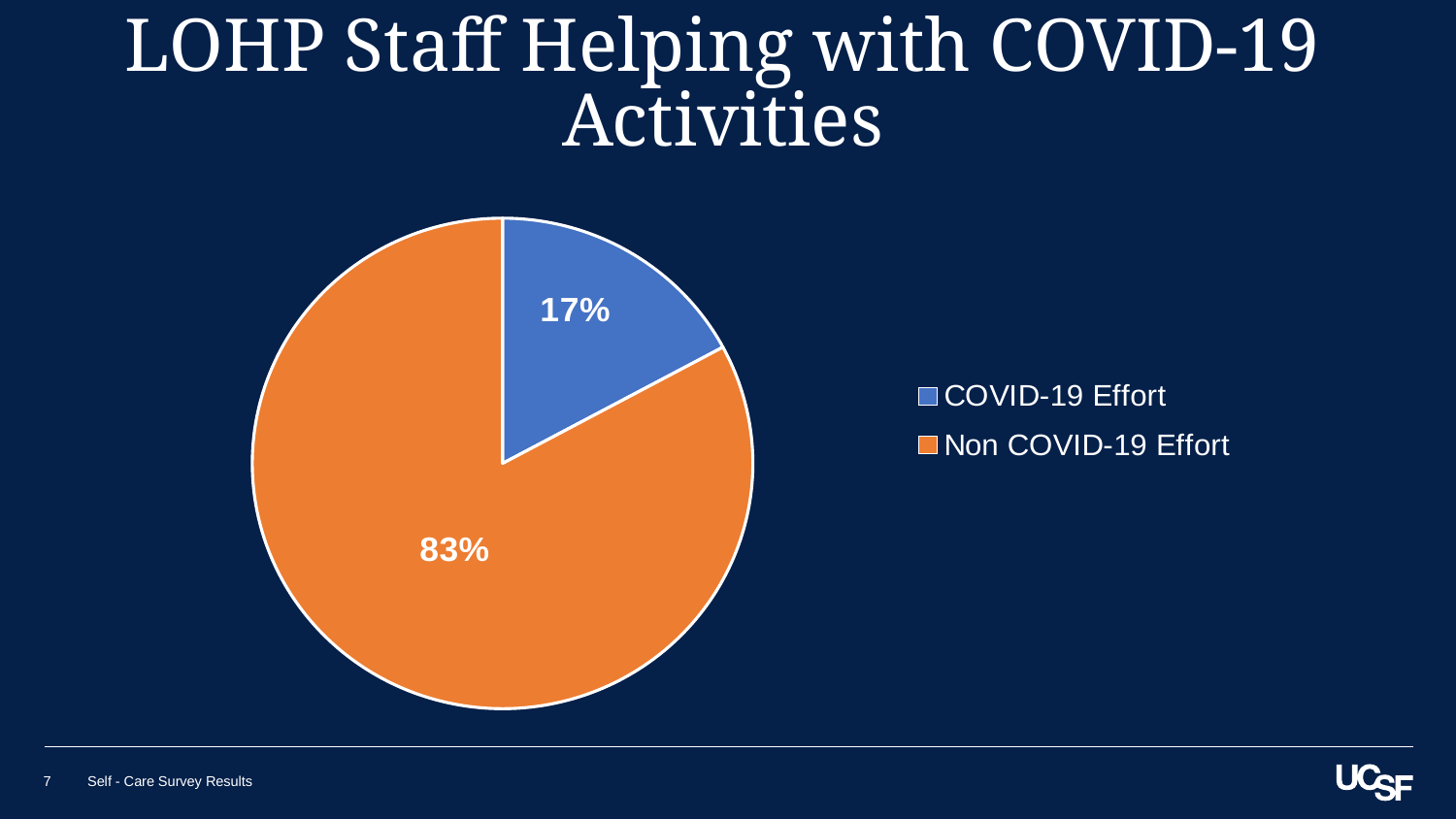
What percentage of the pie is labelled for COVID-19 Effort? 17% What kind of chart is shown on the slide? pie chart Which slice of the pie is the smallest? COVID-19 Effort Which slice of the pie is the largest? Non COVID-19 Effort Which is larger, the COVID-19 Effort slice or the Non COVID-19 Effort slice? Non COVID-19 Effort What colour is the Non COVID-19 Effort slice? orange What is the difference in percentage points between the Non COVID-19 Effort slice and the COVID-19 Effort slice? 66 How many entries does the legend list? 2 What percentage of the pie is labelled for Non COVID-19 Effort? 83% How many slices does the pie chart have? 2 What share of the pie does the COVID-19 Effort slice represent? 17% What is the title of the slide containing the pie chart? LOHP Staff Helping with COVID-19 Activities